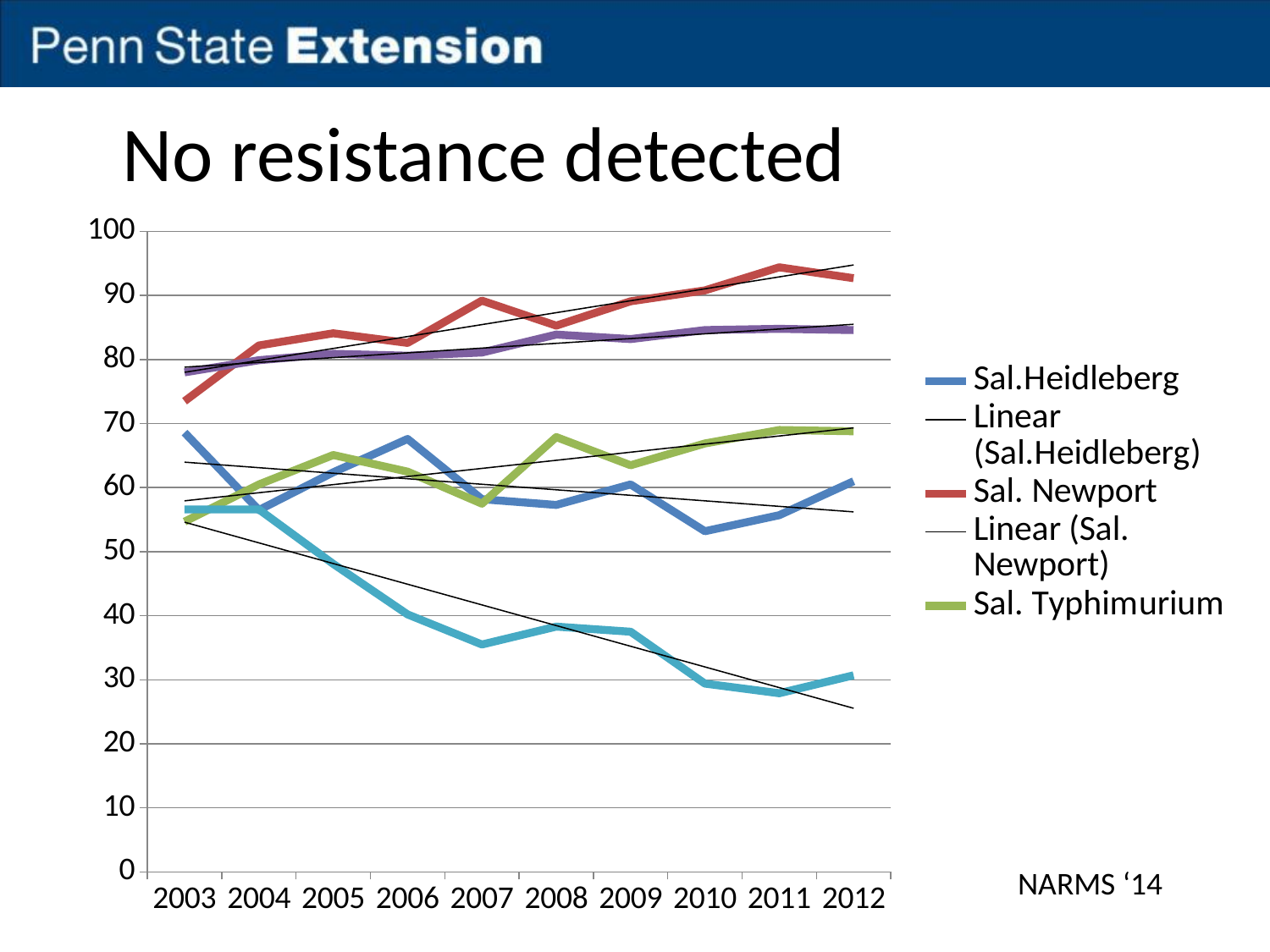
Is the value for Sal.Heidleberg in 2010 greater or less than 50? greater What kind of chart is shown on the slide? Line chart What is the title of the slide above the chart? No resistance detected Is the value for Sal. Newport in 2003 greater or less than 70? greater How many years are shown along the x axis of the chart? 10 In which year is Sal.Heidleberg at its lowest? 2010 Is the value for Sal. Typhimurium in 2008 greater or less than 70? less In which year is Sal. Newport at its highest? 2011 Does the Sal. Newport line generally rise or fall from 2003 to 2012? Rise How many entries does the chart's legend list? 5 In 2012, which is larger: Sal. Newport or Sal.Heidleberg? Sal. Newport